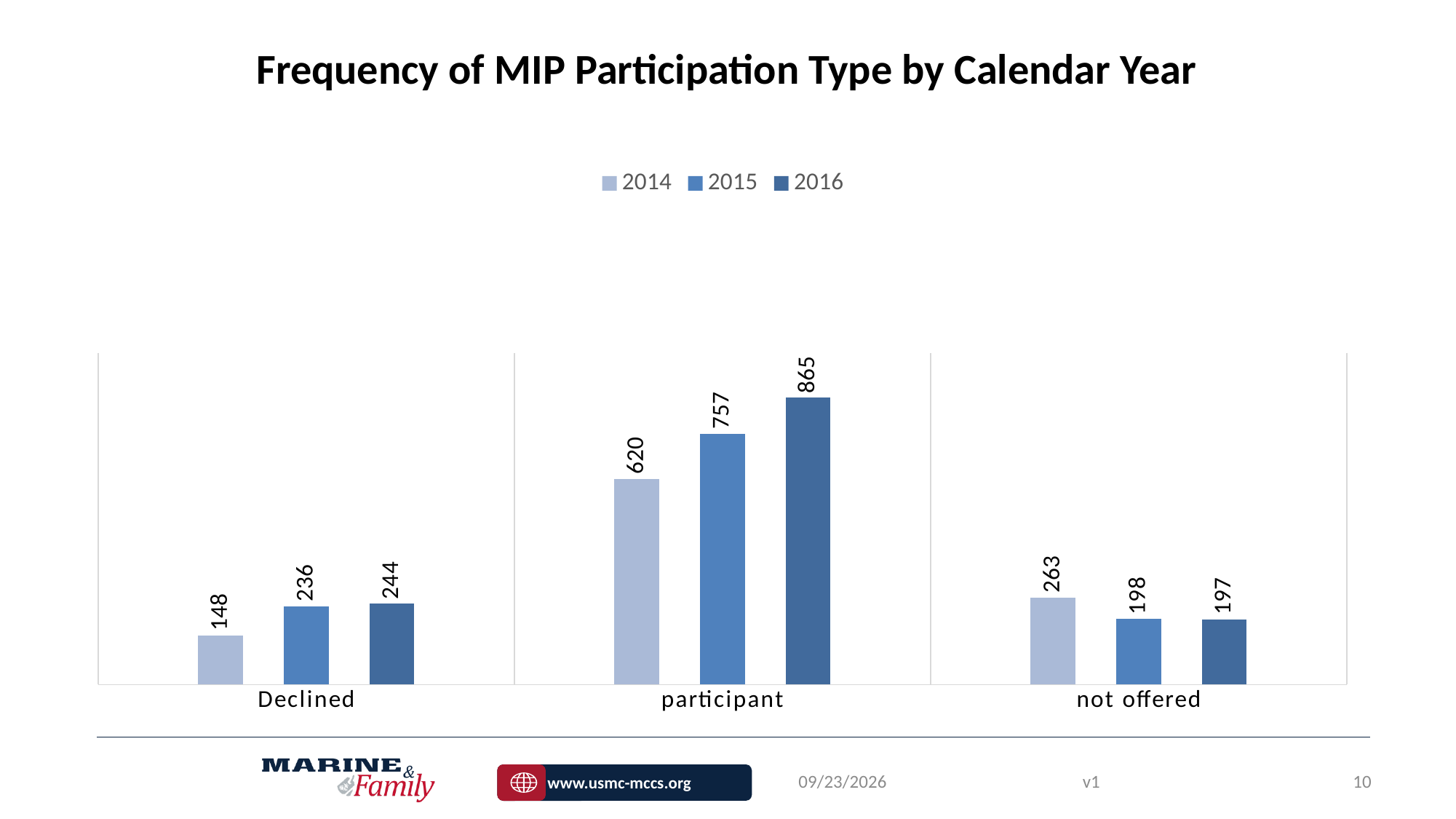
What kind of chart is shown on the slide? bar chart What is the value for 2015 in the not offered category? 198 What is the title of the chart? Frequency of MIP Participation Type by Calendar Year How many categories are shown on the x axis? 3 Do the values for the participant category rise or fall from 2014 to 2016? rise Which is larger: the 2014 value for not offered or the 2016 value for Declined? 2014 value for not offered What is the difference between the 2016 and 2014 values in the participant category? 245 Which year has the lowest value in the Declined category? 2014 What is the value for 2016 in the participant category? 865 How many series does the legend list? 3 What is the value for 2014 in the Declined category? 148 Which category has the highest value for 2015? participant